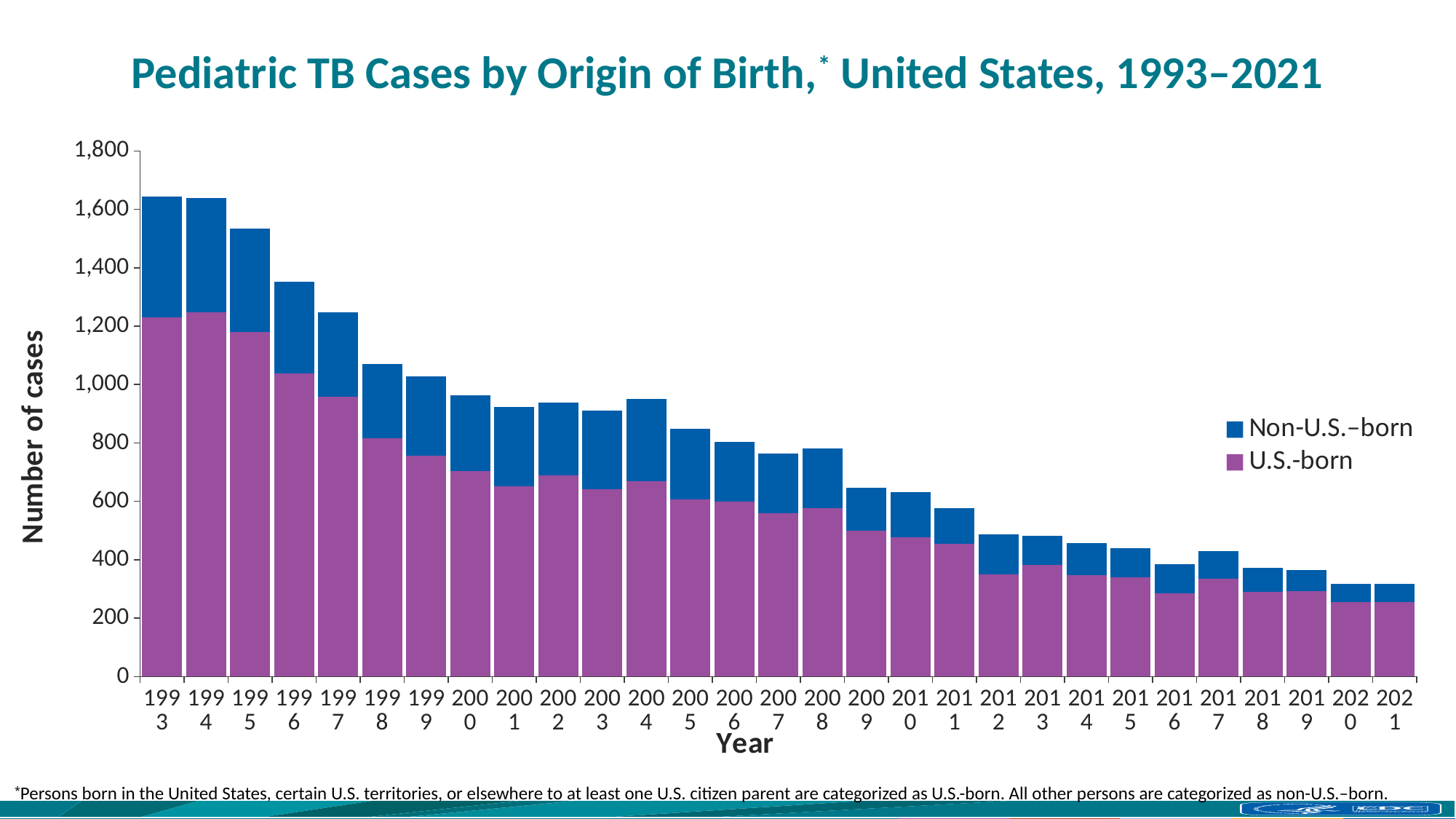
What kind of chart is shown on the slide? Stacked bar chart Do total pediatric TB cases generally rise or fall from 1993 to 2021? Fall Is the total number of cases for 2021 greater or less than 400? less Is the number of U.S.-born cases for 2000 greater or less than 800? less How many years are shown along the x axis? 29 Which year has the larger total number of cases, 1993 or 2021? 1993 Is the total number of cases for 1996 greater or less than 1,200? greater Which colour represents U.S.-born cases in the chart? Purple How many series does the legend list? 2 Which year has the larger total number of cases, 2003 or 2004? 2004